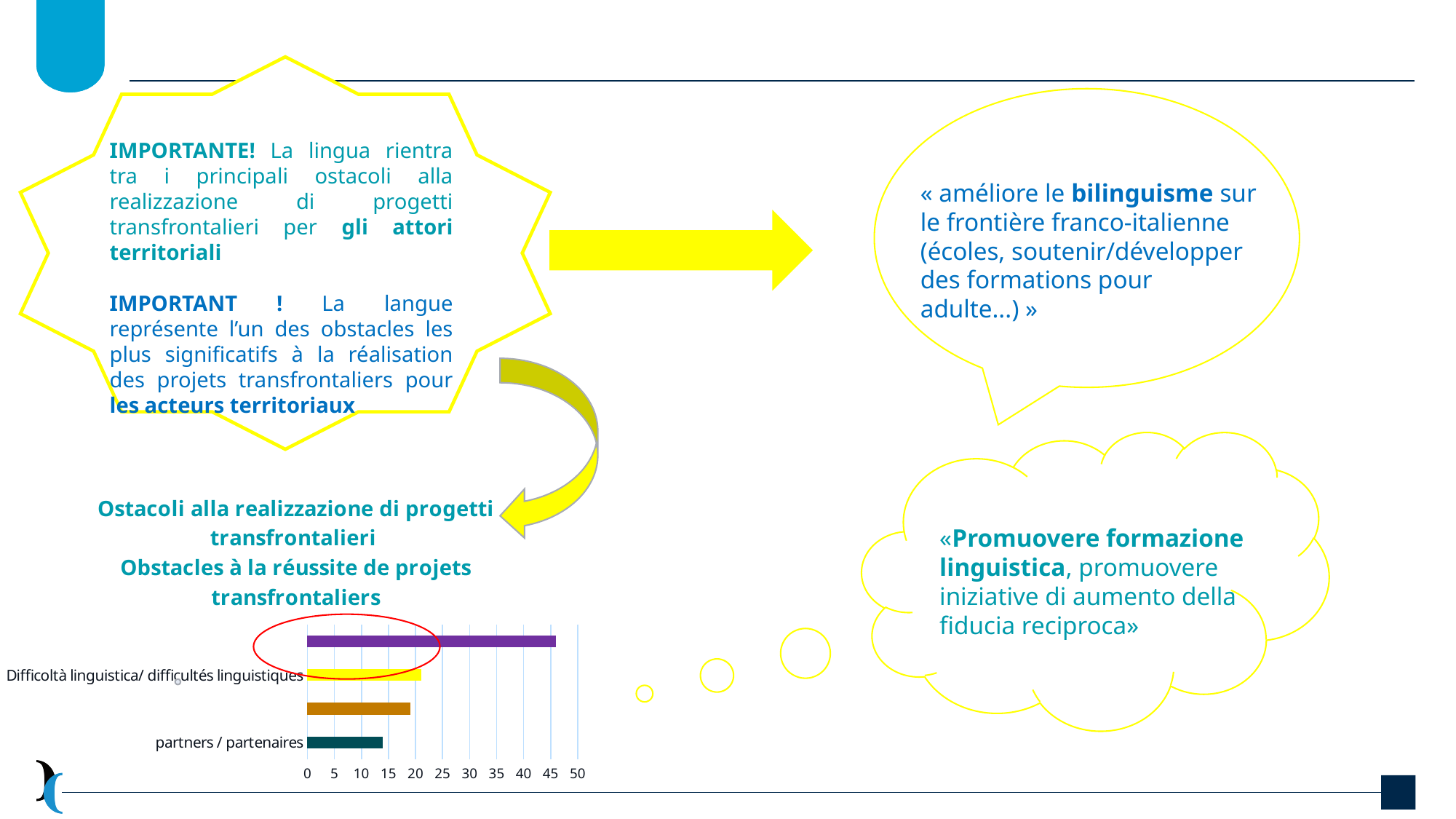
What kind of chart is shown at the bottom left of the slide? bar chart How many bars does the chart show? 4 Which of the labelled categories has the lowest value in the chart? partners / partenaires What is the Italian part of the chart's title? Ostacoli alla realizzazione di progetti transfrontalieri What is the highest tick value shown on the chart's horizontal axis? 50 Is the value for 'Difficoltà linguistica/ difficultés linguistiques' greater or less than 25? less Is the value for 'partners / partenaires' greater or less than 10? greater Which is larger, the value for 'Difficoltà linguistica/ difficultés linguistiques' or the value for 'partners / partenaires'? Difficoltà linguistica/ difficultés linguistiques Is the value for 'partners / partenaires' greater or less than 20? less